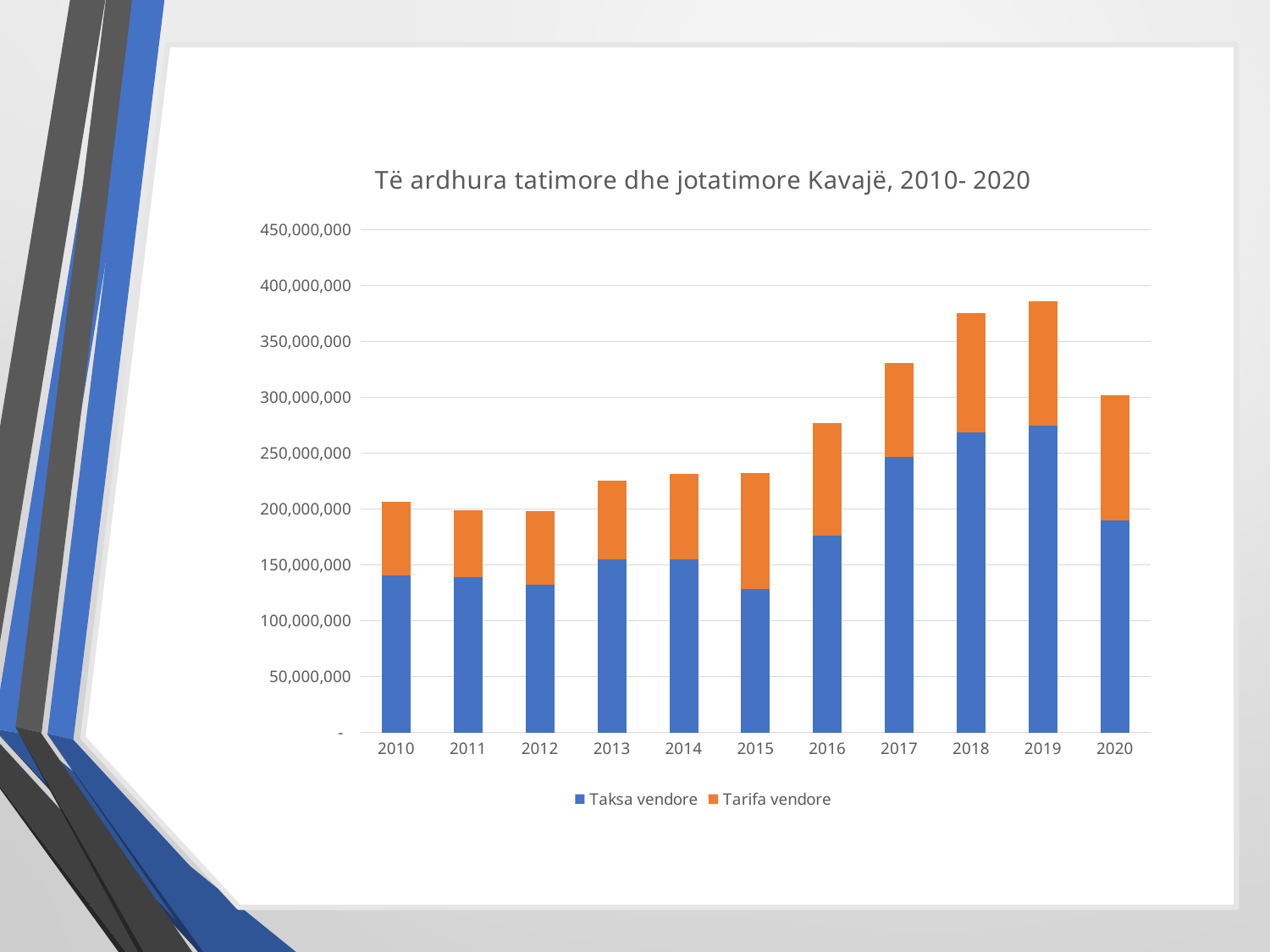
Is the total bar for 2013 greater or less than 250,000,000? less How many years are shown on the x axis? 11 Is the total bar for 2010 greater or less than 200,000,000? greater Which year has the highest total bar? 2019 Is the Taksa vendore value for 2015 greater or less than 150,000,000? less Do the total bars rise or fall from 2016 to 2019? rise What kind of chart is shown on the slide? Stacked bar chart What is the title of the chart? Të ardhura tatimore dhe jotatimore Kavajë, 2010- 2020 Which year has the larger total bar, 2019 or 2020? 2019 How many series does the legend list? 2